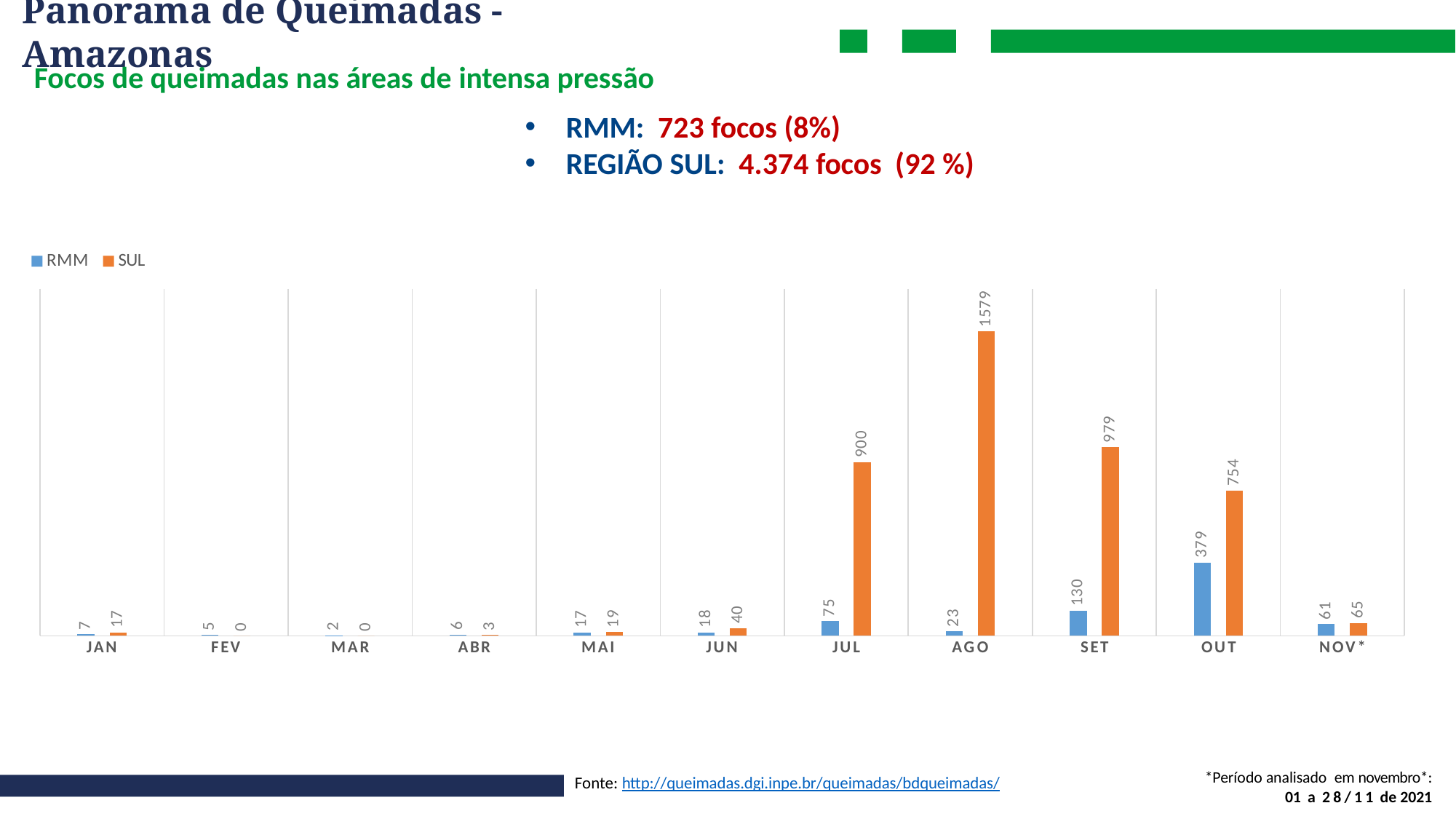
What kind of chart is shown on the slide? Bar chart In which month is the RMM value lowest? MAR What is the difference between the SUL values for AGO and SET? 600 In which month is the RMM value highest? OUT What is the value for SUL in AGO? 1579 In which month is the SUL value highest? AGO How many series does the legend list? 2 What is the value for RMM in SET? 130 How many months are shown on the x axis? 11 What is the value for SUL in JUL? 900 Which is larger in OUT, the RMM value or the SUL value? SUL What is the value for RMM in OUT? 379